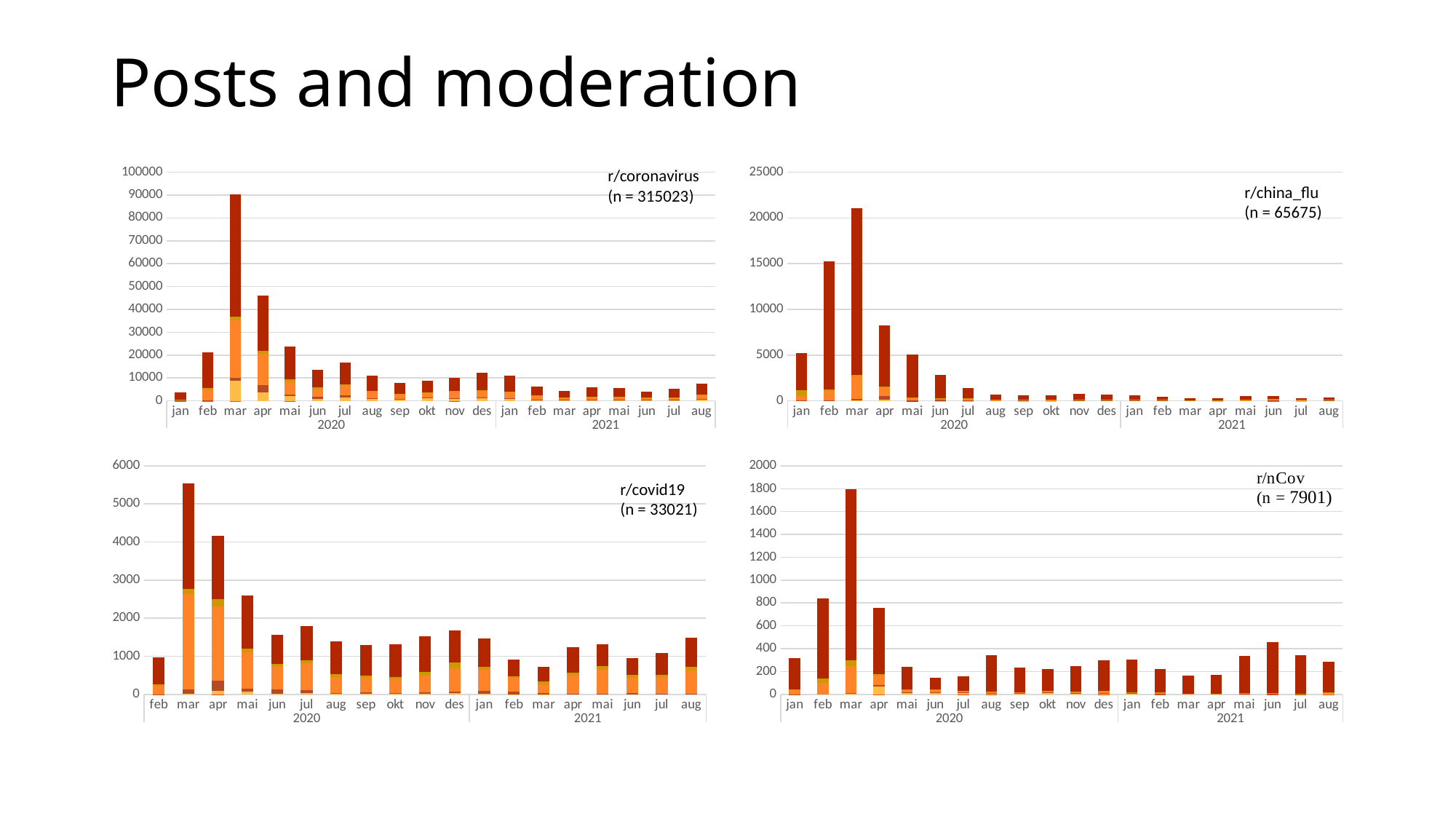
What kind of chart is used for r/coronavirus? bar chart In the r/covid19 chart, which month has the highest bar? mar 2020 In the r/china_flu chart, which month has the highest bar? mar 2020 What is the n value shown for the r/china_flu chart? 65675 In the r/coronavirus chart, which is larger, the bar for mar 2020 or the bar for apr 2020? mar 2020 How many charts are shown on the slide? 4 In the r/coronavirus chart, is the value for mar 2020 greater or less than 80000? greater In the r/china_flu chart, do the bars rise or fall from mar 2020 to aug 2020? fall In the r/china_flu chart, is the value for apr 2020 greater or less than 5000? greater In the r/covid19 chart, is the value for mar 2020 greater or less than 5000? greater In the r/coronavirus chart, which month has the highest bar? mar 2020